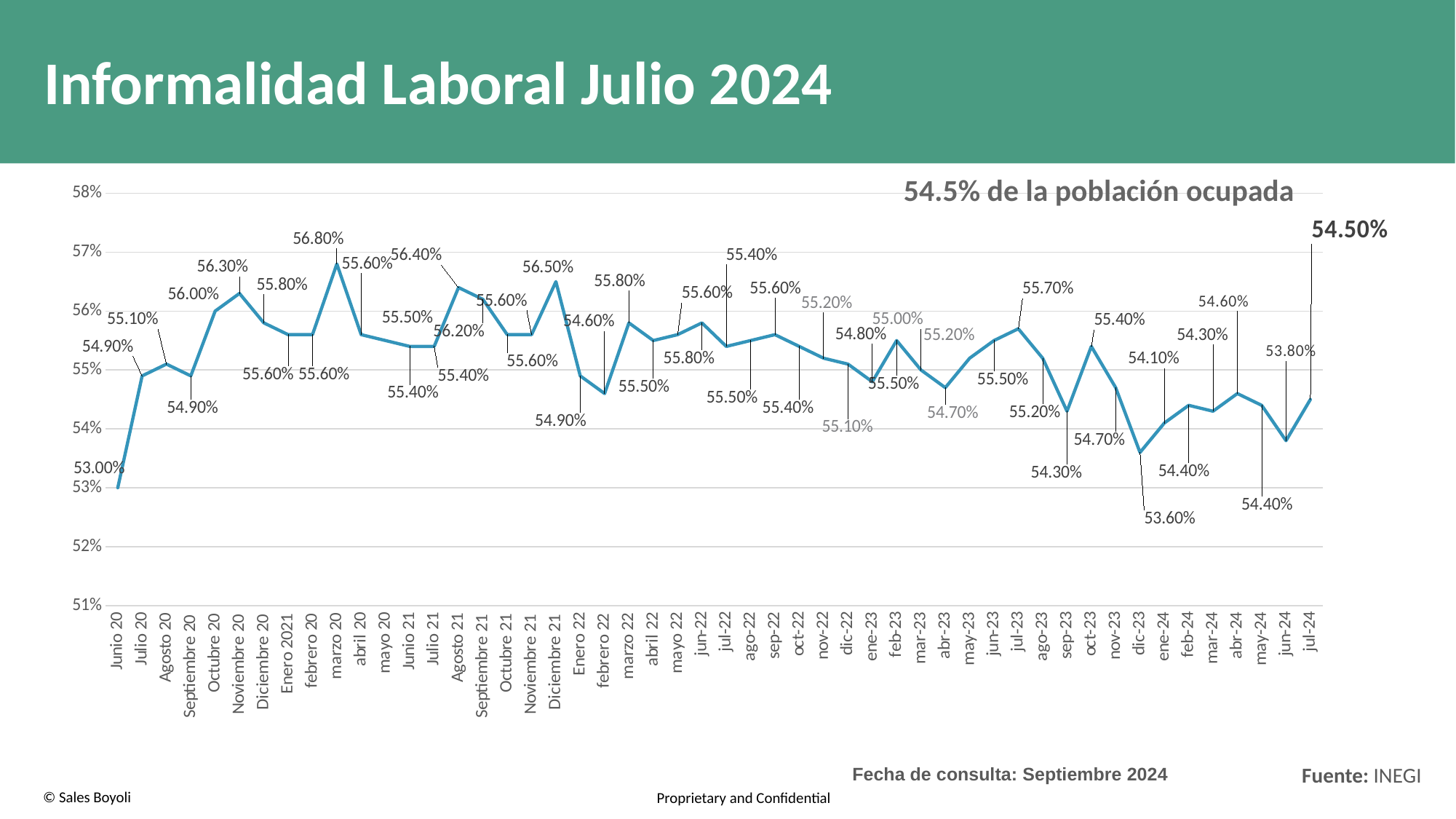
What is the value for Junio 20? 53.00% What is the value for Noviembre 20? 56.30% Which month has the highest value on the chart? marzo 20 What is the difference between the value for jul-24 and the value for jun-24? 0.70% What source is cited for the chart data? INEGI What is the value for dic-23? 53.60% Does the value rise or fall from Junio 20 to Agosto 20? rise What kind of chart is shown on the slide? line chart What is the difference between the highest value (marzo 20) and the lowest value (Junio 20)? 3.80% What is the value for jul-24? 54.50% Which is larger, the value for Noviembre 20 or the value for Octubre 20? Noviembre 20 Which month has the lowest value on the chart? Junio 20